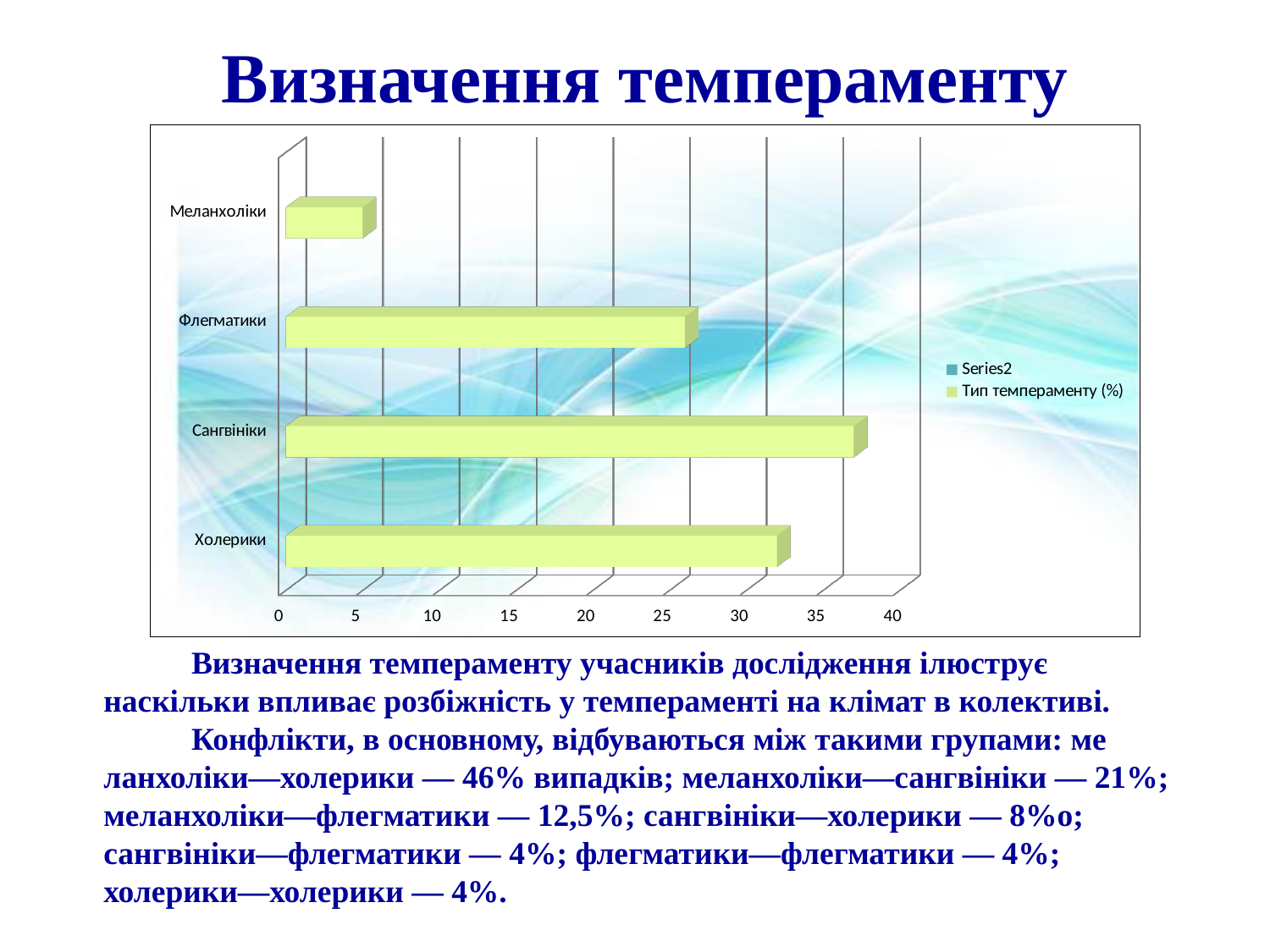
Which temperament category has the lowest value on the chart? Меланхоліки What kind of chart is shown on the slide? Bar chart Is the value for Флегматики greater or less than 30? less Is the value for Меланхоліки greater or less than 10? less What are the two entries listed in the chart legend? Series2 and Тип темпераменту (%) Which is larger, the value for Сангвініки or the value for Холерики? Сангвініки How many series does the chart legend list? 2 Which temperament category has the highest value on the chart? Сангвініки How many temperament categories are plotted on the chart? 4 Is the value for Сангвініки greater or less than 30? greater Which is larger, the value for Флегматики or the value for Холерики? Холерики